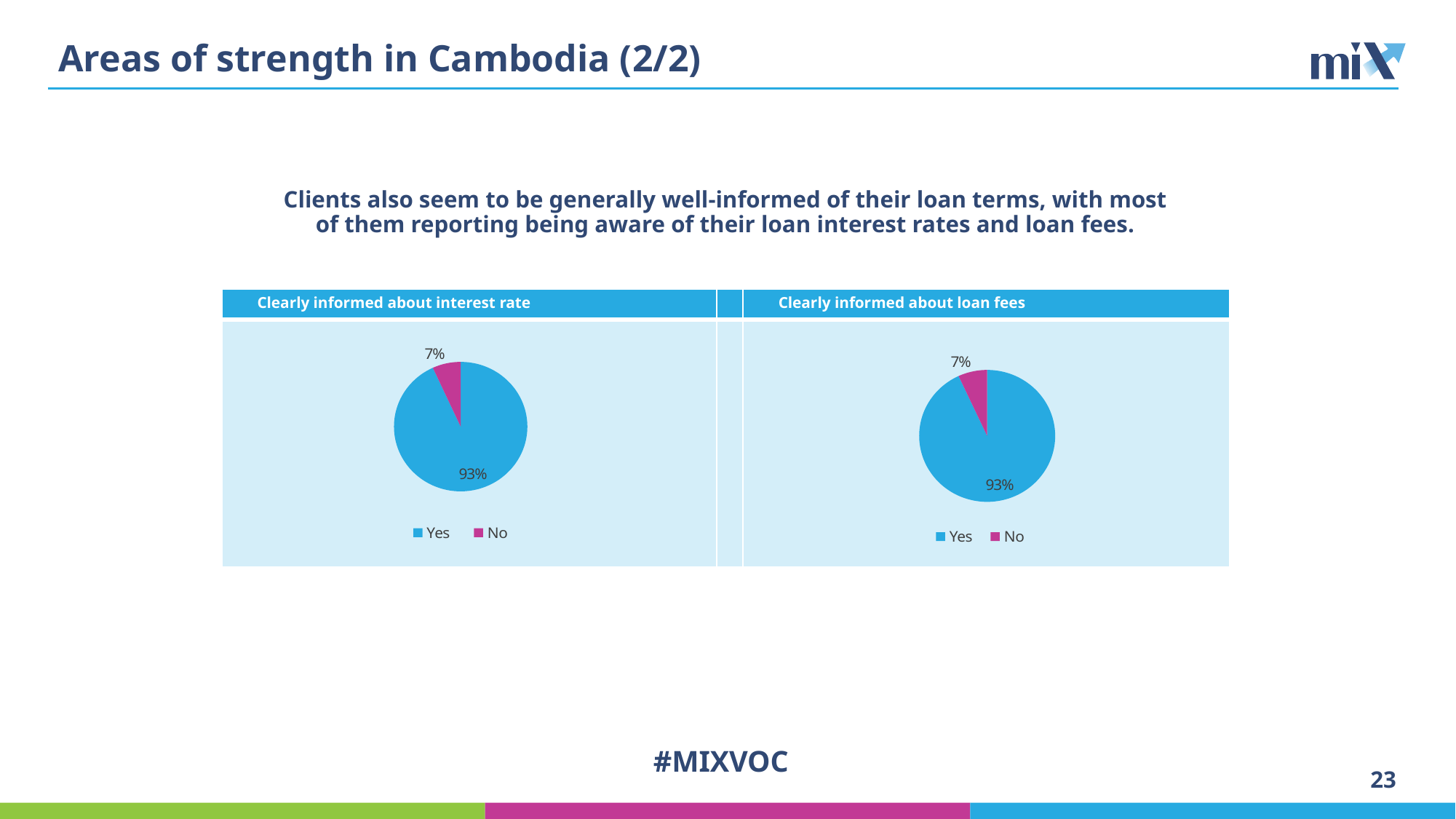
In the 'Clearly informed about interest rate' chart, what is the difference in percentage points between the Yes and No slices? 86 In the 'Clearly informed about loan fees' chart, is the Yes slice larger or smaller than the No slice? larger In the 'Clearly informed about loan fees' chart, what percentage of clients answered No? 7% In the 'Clearly informed about interest rate' chart, what percentage of clients answered No? 7% In the 'Clearly informed about interest rate' chart, what percentage of clients answered Yes? 93% In the 'Clearly informed about interest rate' chart, which response has the largest slice? Yes In the 'Clearly informed about loan fees' chart, which response has the smallest slice? No How many slices does the 'Clearly informed about loan fees' pie chart have? 2 How many entries does the legend of the 'Clearly informed about interest rate' chart list? 2 In the 'Clearly informed about loan fees' chart, what percentage of clients answered Yes? 93% What type of chart is used in the 'Clearly informed about interest rate' panel? pie chart In the 'Clearly informed about loan fees' chart, what colour is the No slice? pink